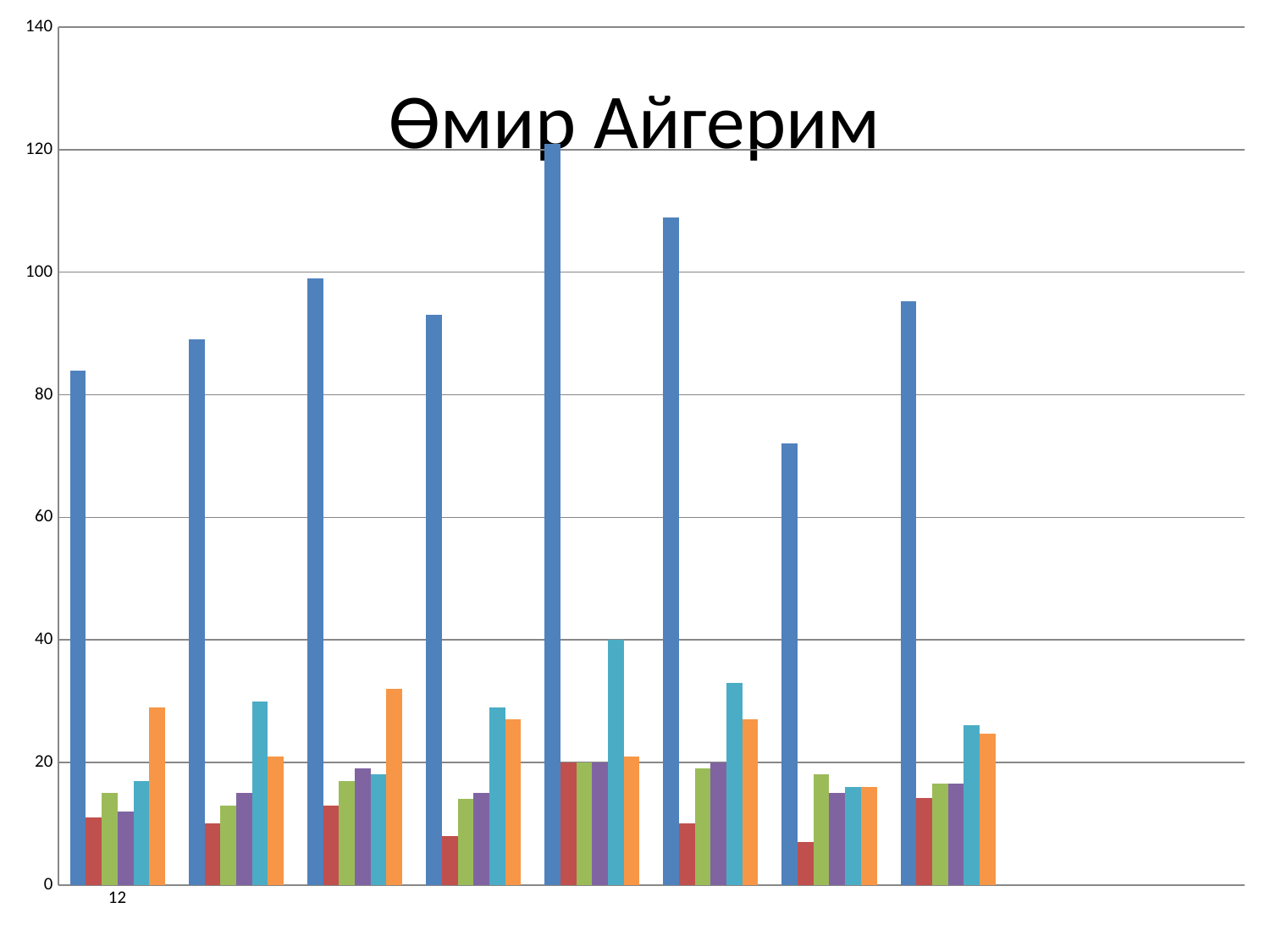
Which group from the left has the tallest blue bar? the fifth group How many bars are there in each group? 6 What kind of chart is shown on the slide? bar chart What is the title of the chart? Өмир Айгерим What colour are the tallest bars in every group? blue Is the blue bar in the sixth group from the left greater or less than 100? greater Is the blue bar in the first group (labelled 12) greater or less than 80? greater How many groups of bars are plotted along the x axis? 8 Is the blue bar in the seventh group from the left greater or less than 80? less Which group from the left has the shortest blue bar? the seventh group Is the blue bar in the fifth group taller than the blue bar in the sixth group? yes